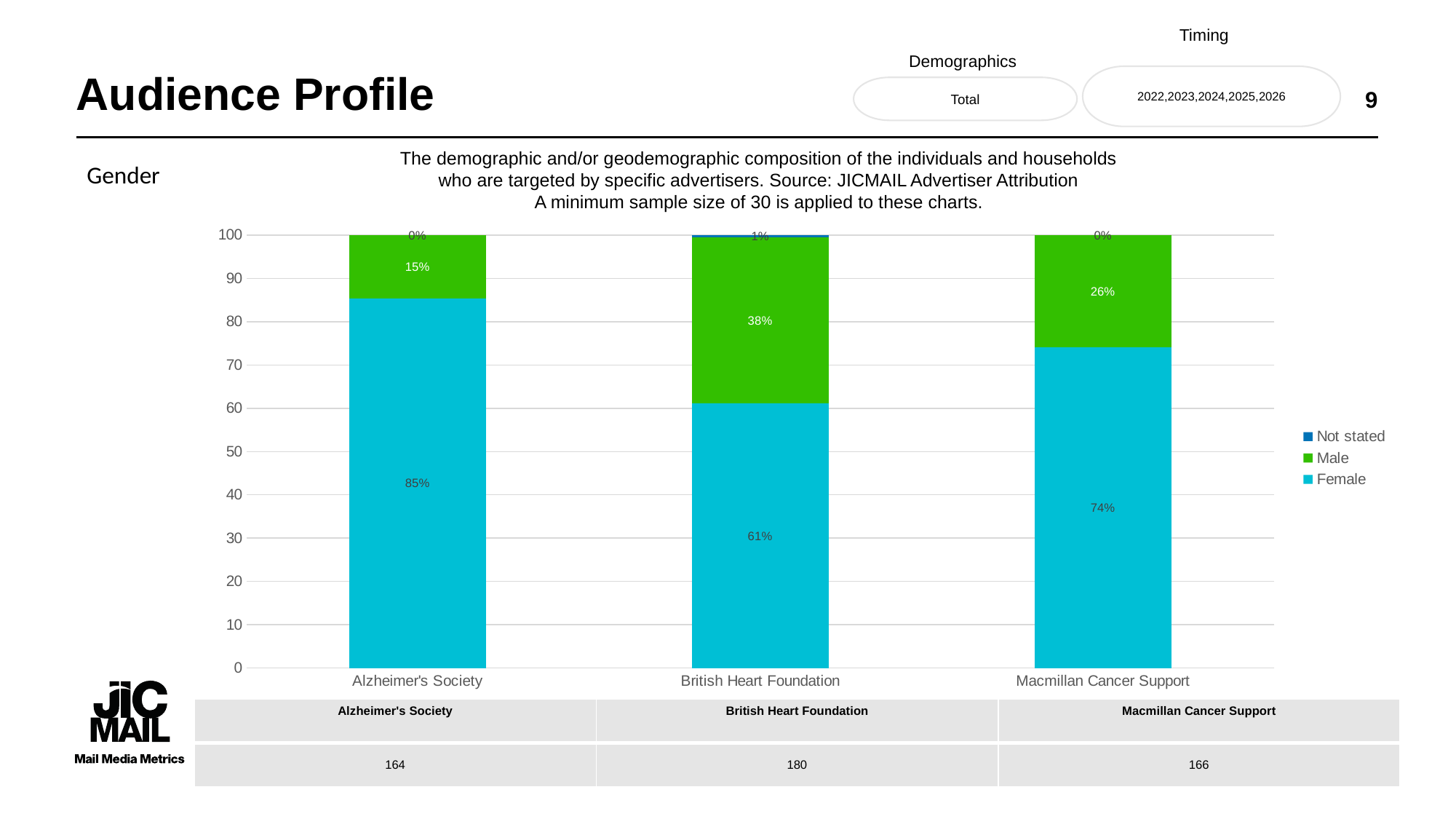
How many series does the legend list? 3 What is the Not stated share for British Heart Foundation? 1% What is the Female share for Macmillan Cancer Support? 74% How many advertisers are shown on the x axis? 3 Which is larger: the Male share for Macmillan Cancer Support or for British Heart Foundation? British Heart Foundation Which advertiser has the lowest Male share? Alzheimer's Society What is the Male share for British Heart Foundation? 38% What is the difference between the Female share for Alzheimer's Society and British Heart Foundation? 24% Which colour represents Female in the legend? Light blue Which advertiser has the highest Female share? Alzheimer's Society What is the Female share for Alzheimer's Society? 85% What kind of chart is shown? Stacked bar chart